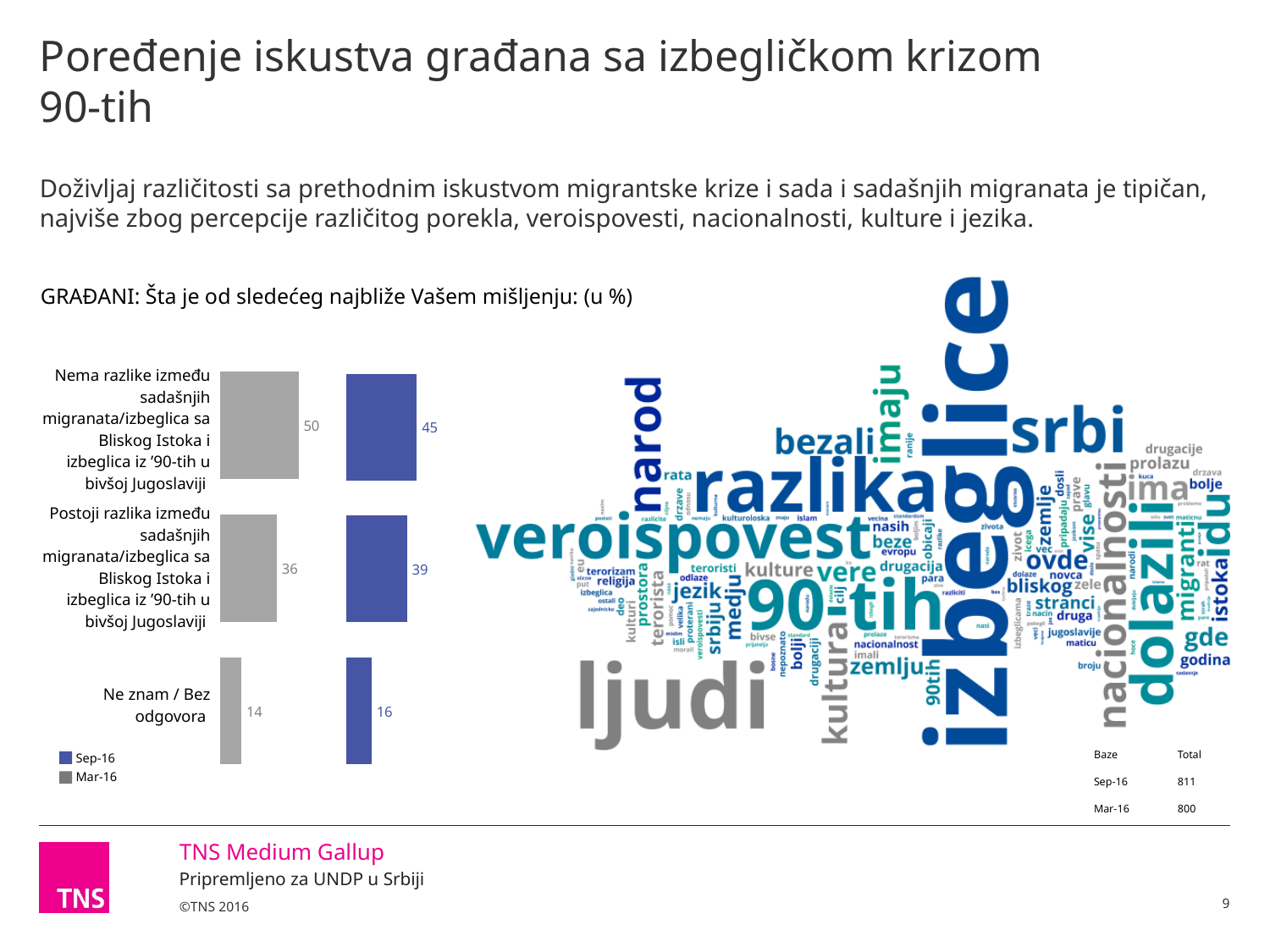
What is the Mar-16 value for "Nema razlike između sadašnjih migranata/izbeglica sa Bliskog Istoka i izbeglica iz '90-tih u bivšoj Jugoslaviji"? 50 How many series does the legend of the bar chart list? 2 Which category has the highest Mar-16 value? Nema razlike između sadašnjih migranata/izbeglica sa Bliskog Istoka i izbeglica iz '90-tih u bivšoj Jugoslaviji What is the Mar-16 value for "Ne znam / Bez odgovora"? 14 For "Postoji razlika između sadašnjih migranata/izbeglica sa Bliskog Istoka i izbeglica iz '90-tih u bivšoj Jugoslaviji", which is larger: the Sep-16 value or the Mar-16 value? Sep-16 How many categories does the bar chart show? 3 What is the Sep-16 value for "Postoji razlika između sadašnjih migranata/izbeglica sa Bliskog Istoka i izbeglica iz '90-tih u bivšoj Jugoslaviji"? 39 What is the Sep-16 value for "Nema razlike između sadašnjih migranata/izbeglica sa Bliskog Istoka i izbeglica iz '90-tih u bivšoj Jugoslaviji"? 45 What is the difference between the Mar-16 and Sep-16 values for "Nema razlike između sadašnjih migranata/izbeglica sa Bliskog Istoka i izbeglica iz '90-tih u bivšoj Jugoslaviji"? 5 Which colour represents the Sep-16 series in the bar chart? Blue What kind of chart is used to show the responses to "Šta je od sledećeg najbliže Vašem mišljenju"? Bar chart Which category has the lowest Sep-16 value? Ne znam / Bez odgovora